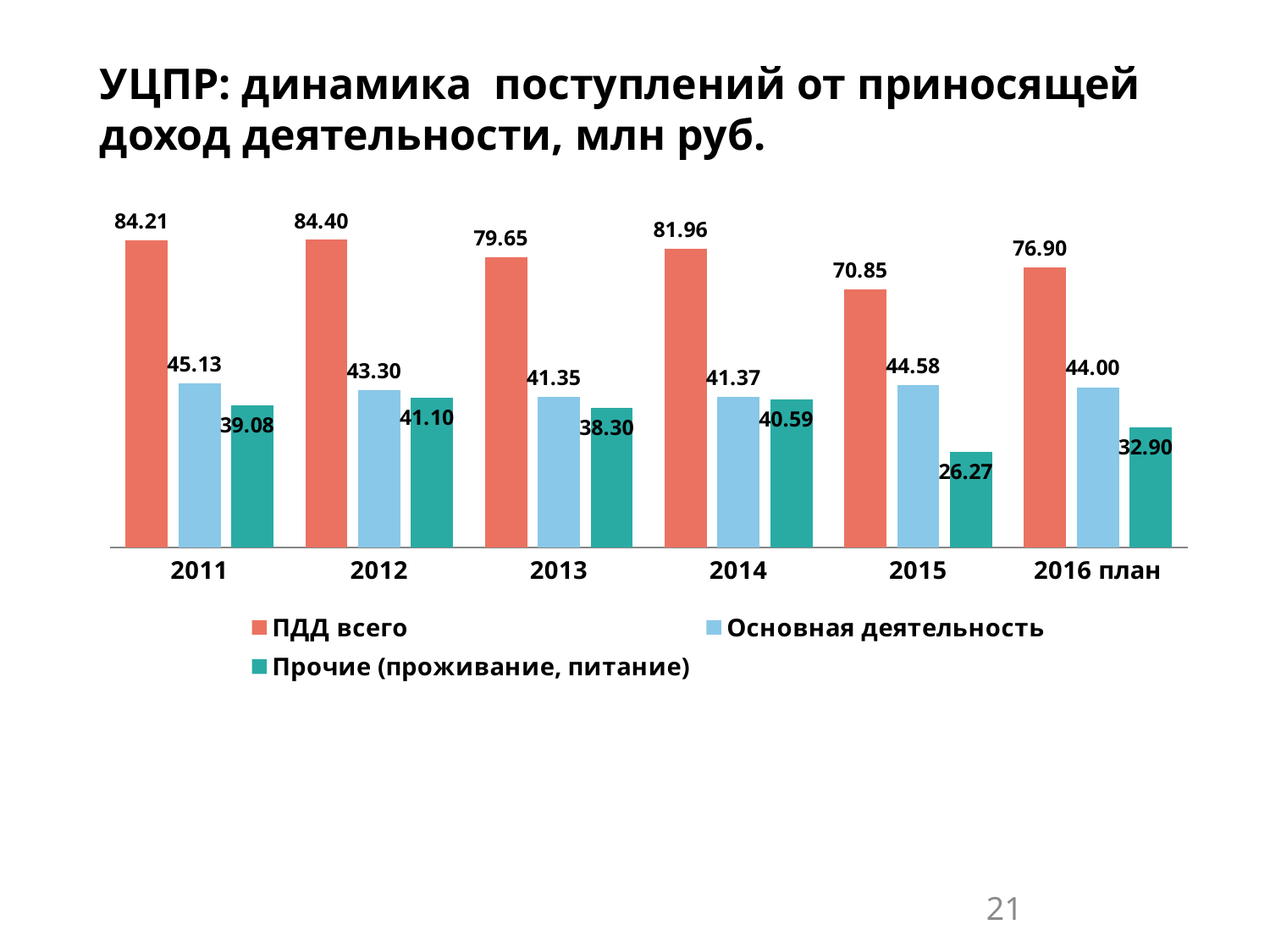
In which year is Прочие (проживание, питание) the lowest? 2015 In which year is ПДД всего the highest? 2012 What is the value of ПДД всего for 2014? 81.96 Which series is shown in red/orange bars? ПДД всего How many series does the legend list? 3 Which is larger: Основная деятельность in 2011 or in 2016 план? 2011 How many years (categories) are shown on the x axis? 6 Does ПДД всего rise or fall from 2014 to 2015? Fall What is the difference between ПДД всего in 2012 and in 2015? 13.55 What is the value of Основная деятельность for 2015? 44.58 What kind of chart is shown on the slide? Bar chart What is the value of Прочие (проживание, питание) for 2016 план? 32.90